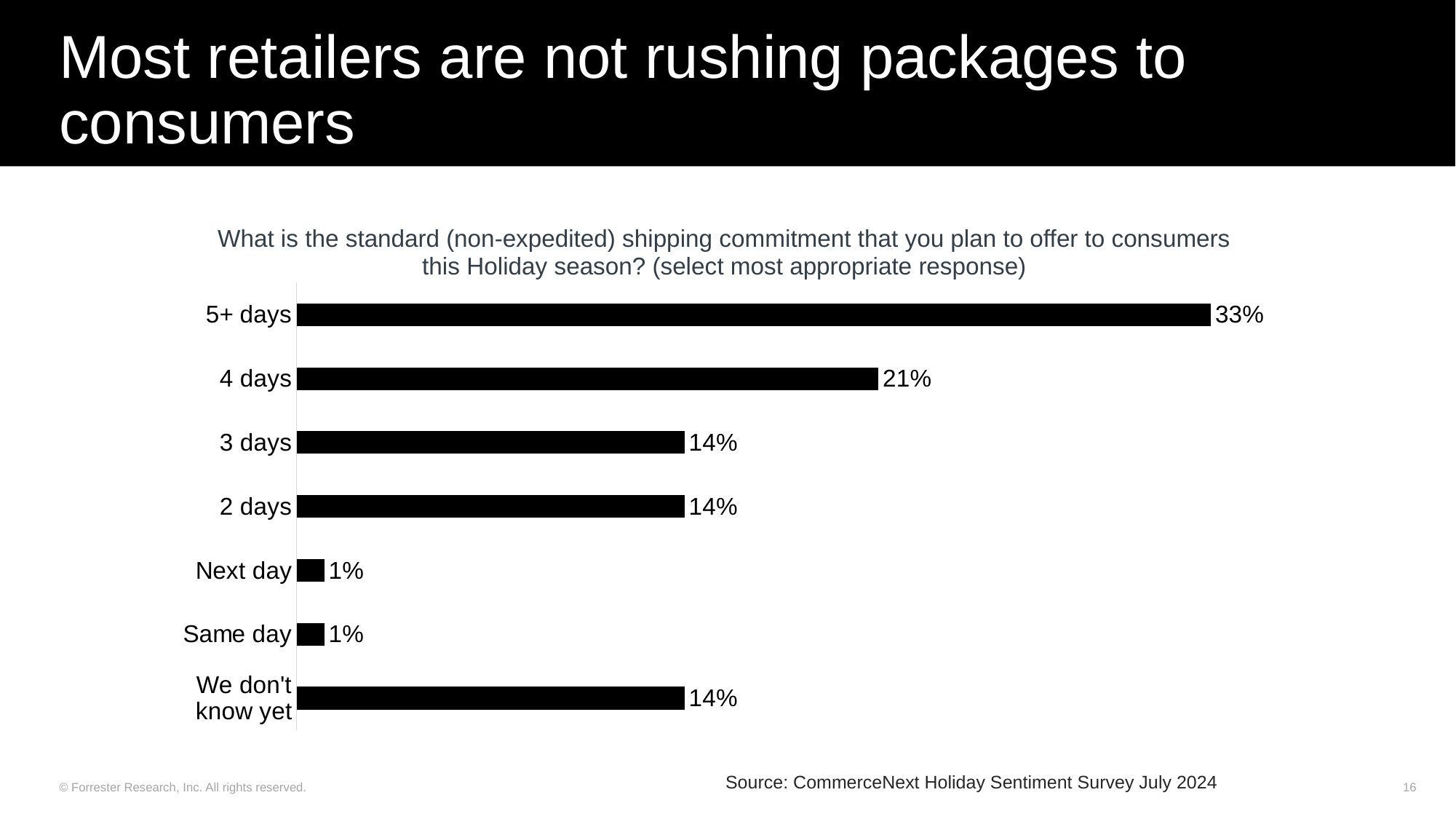
What percentage of retailers selected 'We don't know yet'? 14% How many categories are shown in the chart? 7 What is the difference between the values for 5+ days and 4 days? 12 percentage points Which is larger, the value for 4 days or the value for 2 days? 4 days What percentage of retailers plan to offer a 5+ days standard shipping commitment? 33% How many categories share the value 14%? 3 What is the value for 4 days? 21% What kind of chart is shown on the slide? Bar chart What is the difference between the values for 4 days and 3 days? 7 percentage points What is the source cited for the chart data? CommerceNext Holiday Sentiment Survey July 2024 What is the value for Same day? 1% Which shipping commitment has the highest percentage? 5+ days